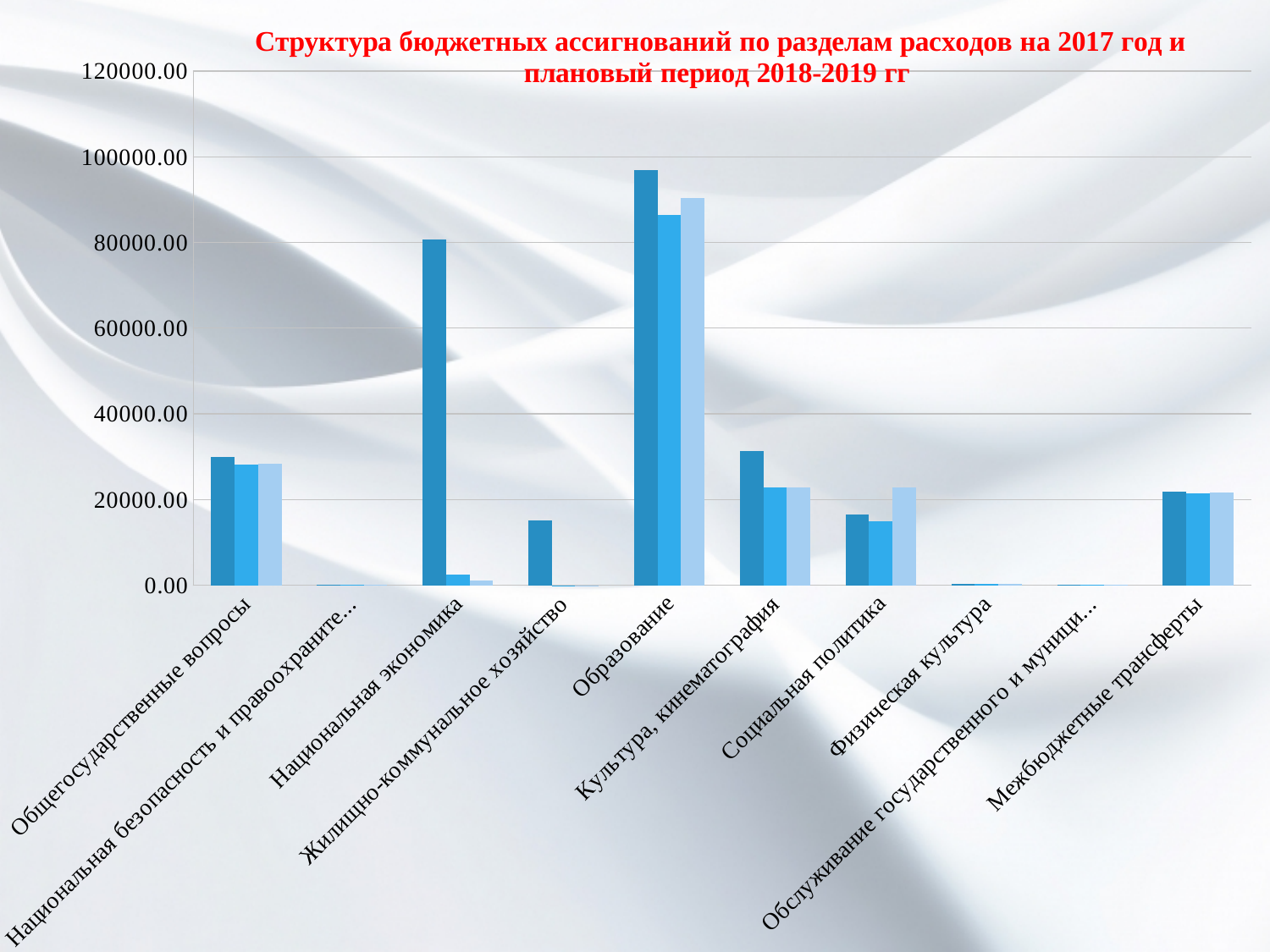
Is the tallest bar for Межбюджетные трансферты greater or less than 40000.00? less Which has the taller first (darkest) bar: Культура, кинематография or Социальная политика? Культура, кинематография How many expenditure categories are shown along the x axis? 10 Which category has the highest bars on the chart? Образование Is the tallest bar for Образование greater or less than 80000.00? greater Which has the taller first (darkest) bar: Образование or Национальная экономика? Образование Is the tallest bar for Национальная экономика greater or less than 60000.00? greater What kind of chart is shown on the slide? bar chart What is the title of the chart? Структура бюджетных ассигнований по разделам расходов на 2017 год и плановый период 2018-2019 гг How many bars are plotted for each category? 3